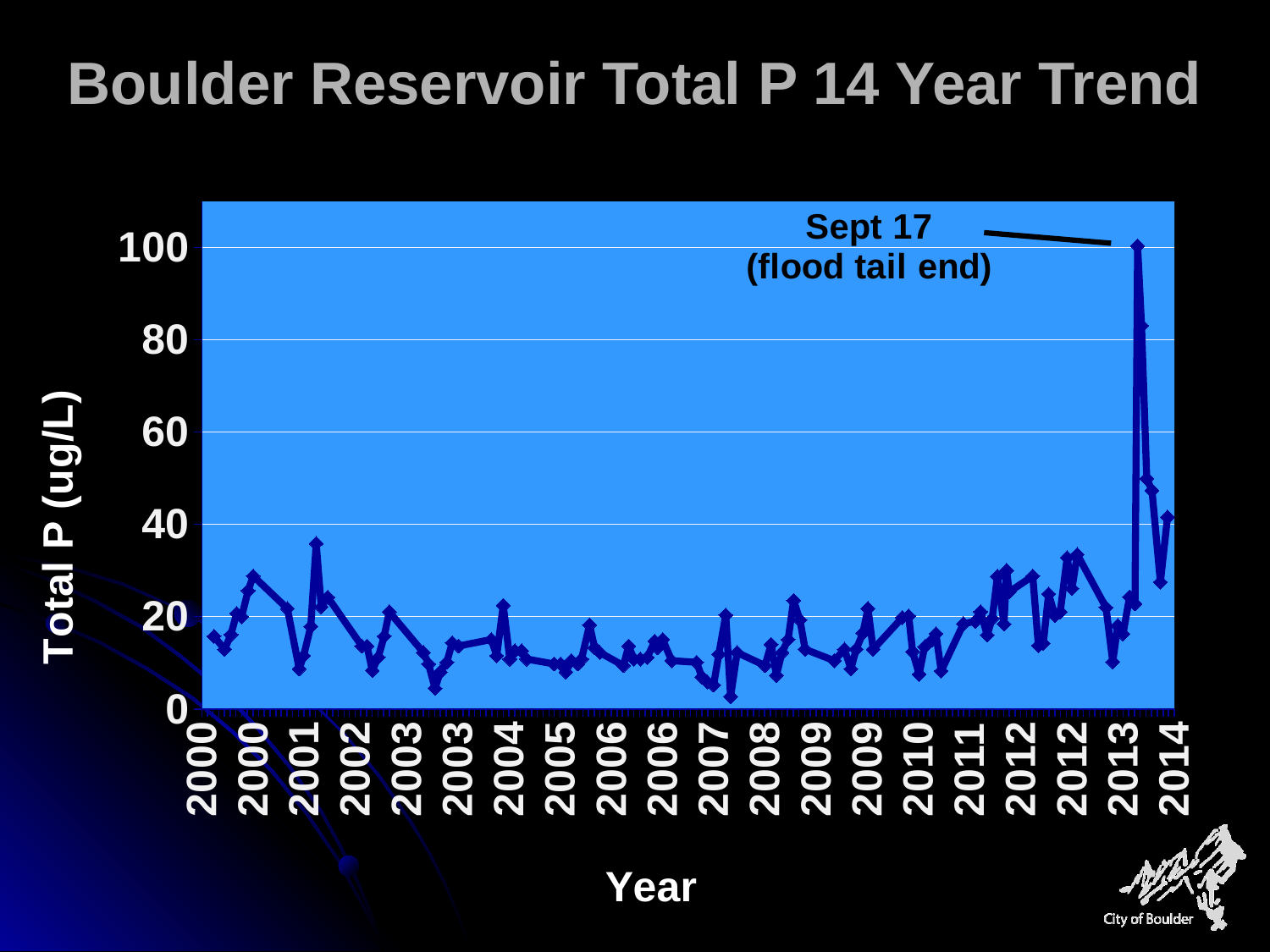
Is the highest Total P value in 2012 greater or less than 60 ug/L? less What event does the annotation attribute the spike in 2013 to? Sept 17 (flood tail end) Is the lowest Total P value in 2007 greater or less than 20 ug/L? less Between 2007 and 2012, do the Total P values generally rise or fall? rise Is the first Total P value plotted in 2000 greater or less than 40 ug/L? less What is the title of the chart? Boulder Reservoir Total P 14 Year Trend What kind of chart is shown on the slide? Line chart In which year does Total P reach its highest value? 2013 Which is larger, the peak Total P value in 2013 or the peak Total P value in 2001? 2013 What is the highest value shown on the y axis? 100